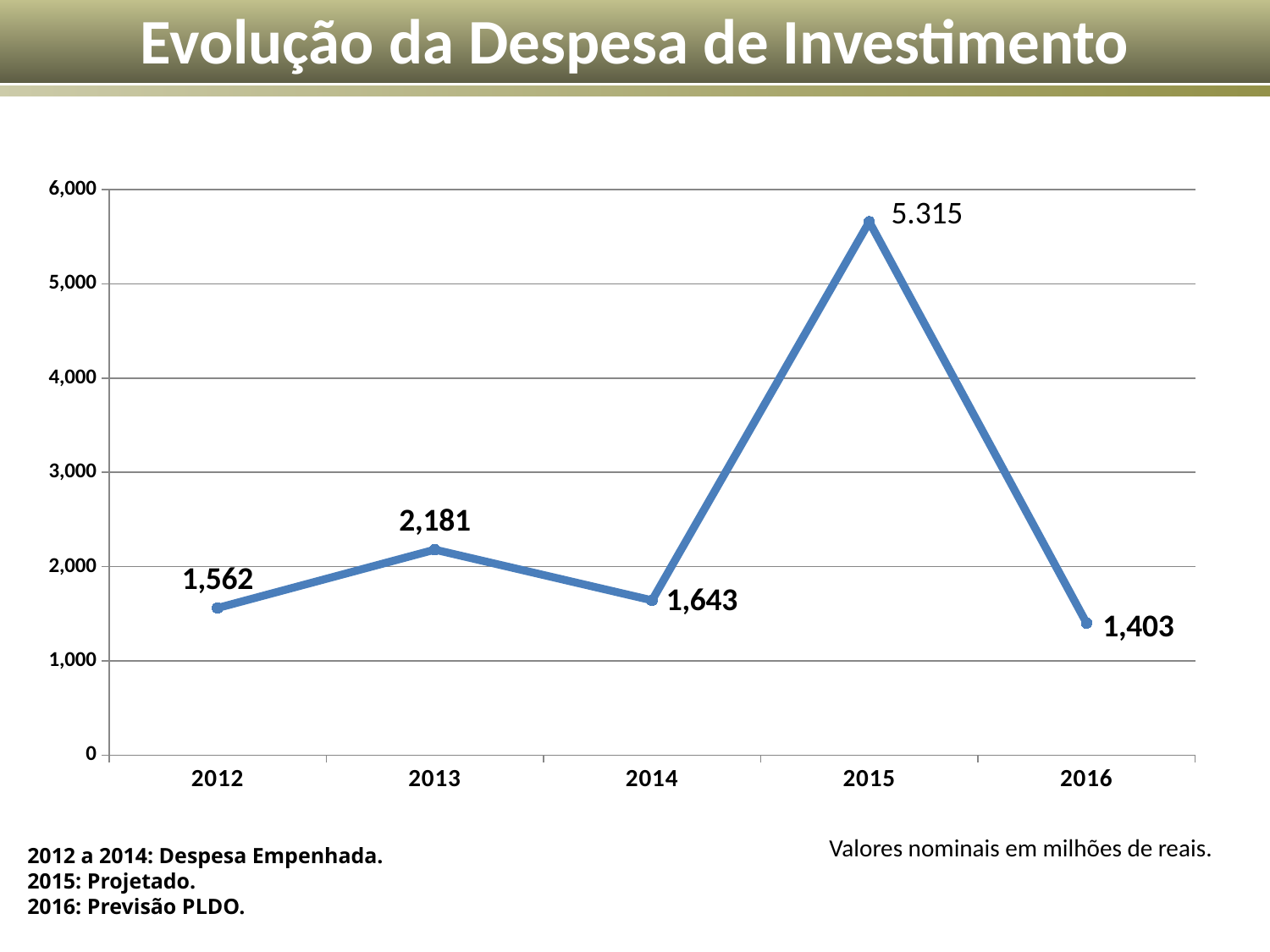
What is the value labelled for 2015? 5.315 What is the value for 2016? 1,403 Which is larger, the value for 2014 or the value for 2012? 2014 How many years are plotted on the x axis? 5 Which year has the lowest value? 2016 What is the value for 2013? 2,181 What kind of chart is shown? line chart Which year has the highest value? 2015 Is the value for 2015 greater or less than 5,000? greater What is the value for 2012? 1,562 What is the difference between the values for 2013 and 2012? 619 What is the value for 2014? 1,643